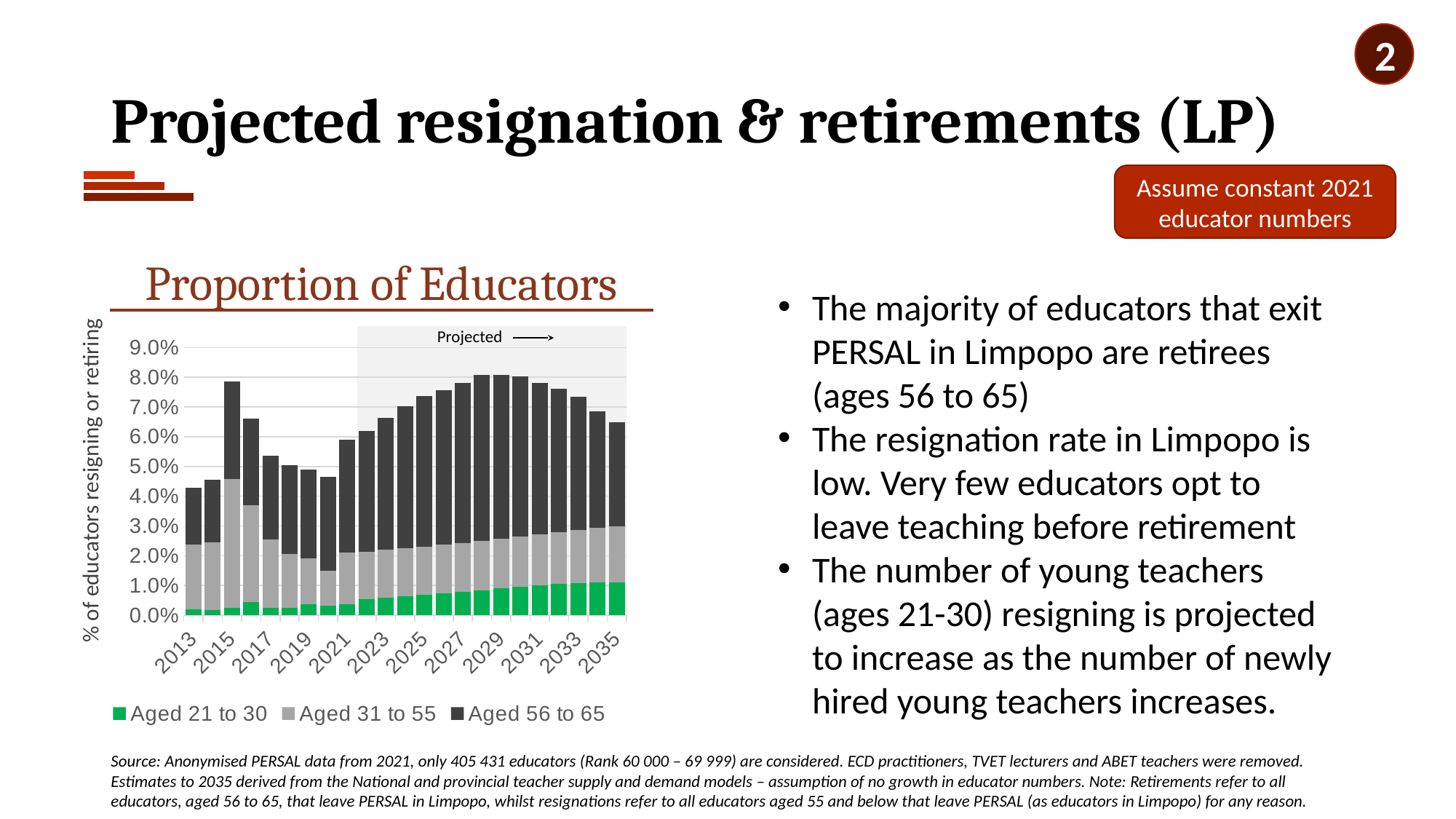
What is the title of the chart? Proportion of Educators Is the total value of the bar for 2015 greater or less than 7.0%? greater Is the total value of the bar for 2013 greater or less than 5.0%? less How many years (bars) are plotted in the chart? 23 Which year has the larger total bar, 2013 or 2015? 2015 Is the total value of the bar for 2021 greater or less than 5.0%? greater What kind of chart is shown on the slide? Stacked bar chart Which age group makes up the largest segment of the 2029 bar? Aged 56 to 65 Do the total bar values rise or fall from 2022 to 2029? Rise What are the three series listed in the chart legend? Aged 21 to 30, Aged 31 to 55, Aged 56 to 65 How many series does the chart legend list? 3